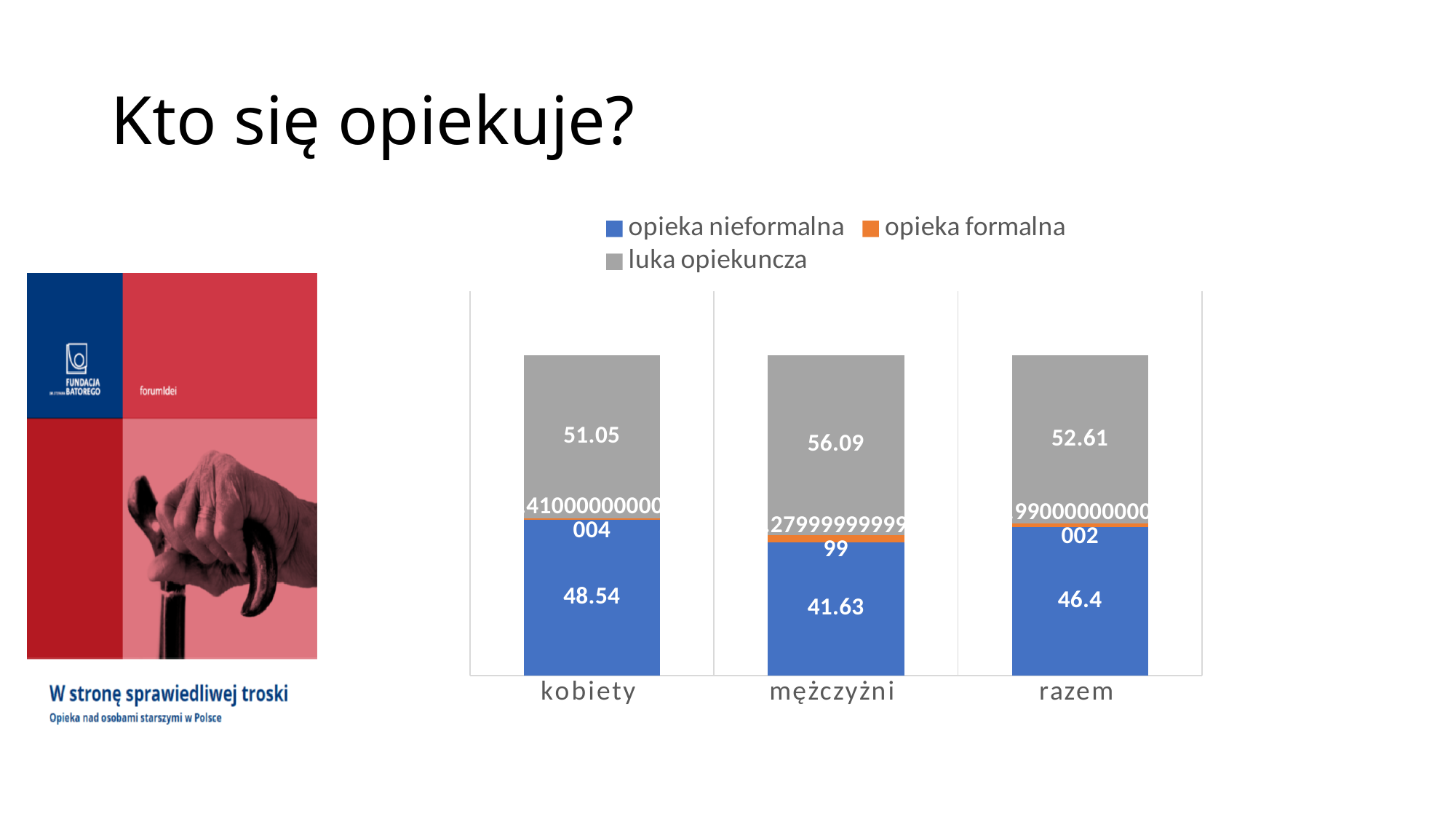
Which category has the lowest value for opieka nieformalna? mężczyźni What kind of chart is shown on the slide? stacked bar chart What is the value of luka opiekuncza for razem? 52.61 How many series does the legend list? 3 What is the value of opieka nieformalna for razem? 46.4 Which is larger for kobiety: opieka nieformalna or luka opiekuncza? luka opiekuncza How many categories are shown on the x axis? 3 Which category has the highest value for luka opiekuncza? mężczyźni What is the value of luka opiekuncza for mężczyźni? 56.09 What is the difference between the opieka nieformalna values for kobiety and mężczyźni? 6.91 What is the difference between the luka opiekuncza values for mężczyźni and kobiety? 5.04 What is the value of opieka nieformalna for kobiety? 48.54